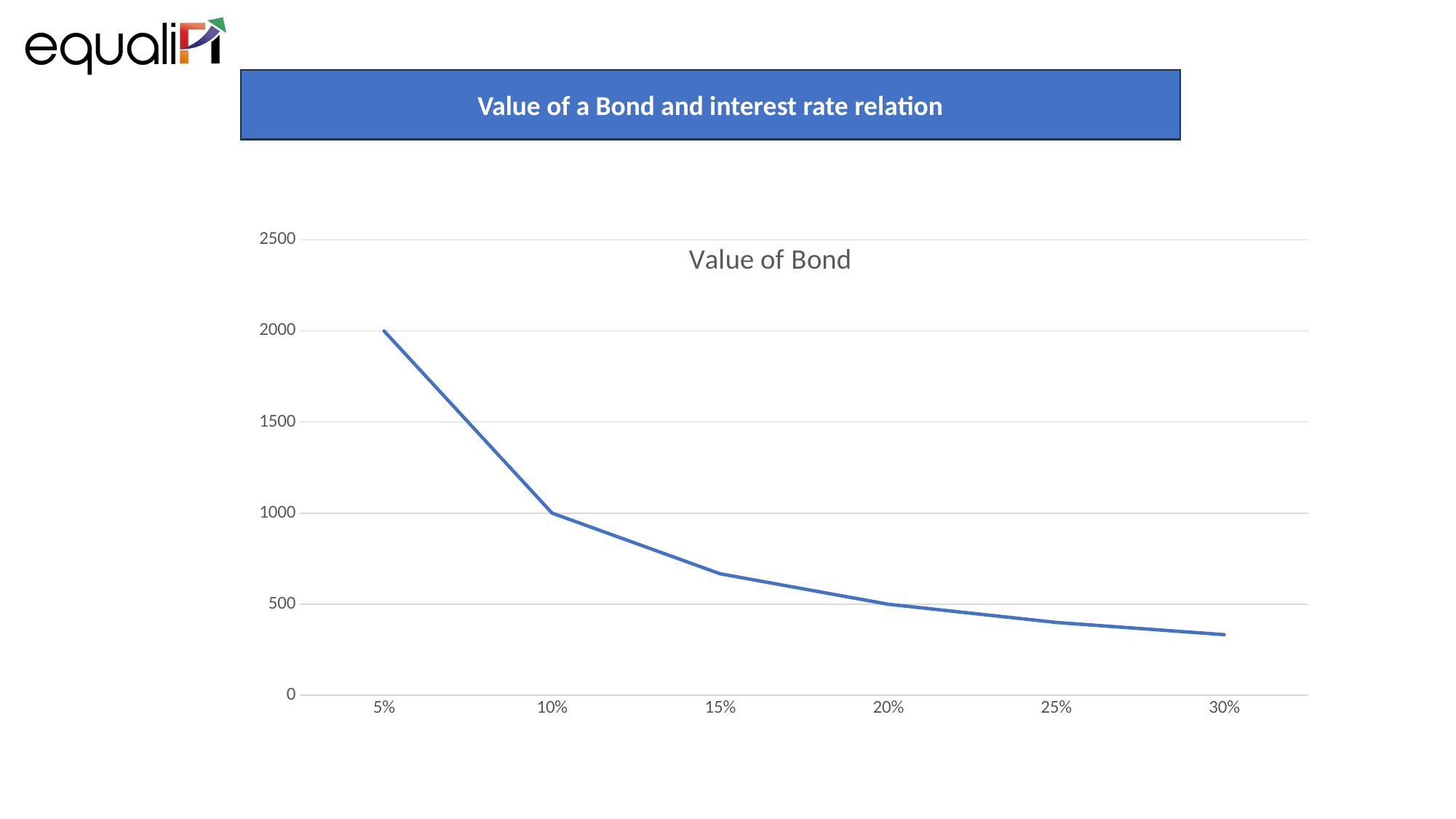
What is the title of the chart? Value of Bond At which interest rate is the value of the bond lowest? 30% Which is larger, the bond value at 10% or at 20%? 10% Is the value of the bond at 25% greater or less than 500? less What is the value of the bond at an interest rate of 10%? 1000 How many interest rate points are plotted on the x axis? 6 At which interest rate is the value of the bond highest? 5% What is the difference between the bond value at 5% and at 10%? 1000 What is the value of the bond at an interest rate of 5%? 2000 Is the value of the bond at 15% greater or less than 500? greater Does the value of the bond rise or fall as the interest rate increases along the x axis? fall What kind of chart is shown on the slide? line chart